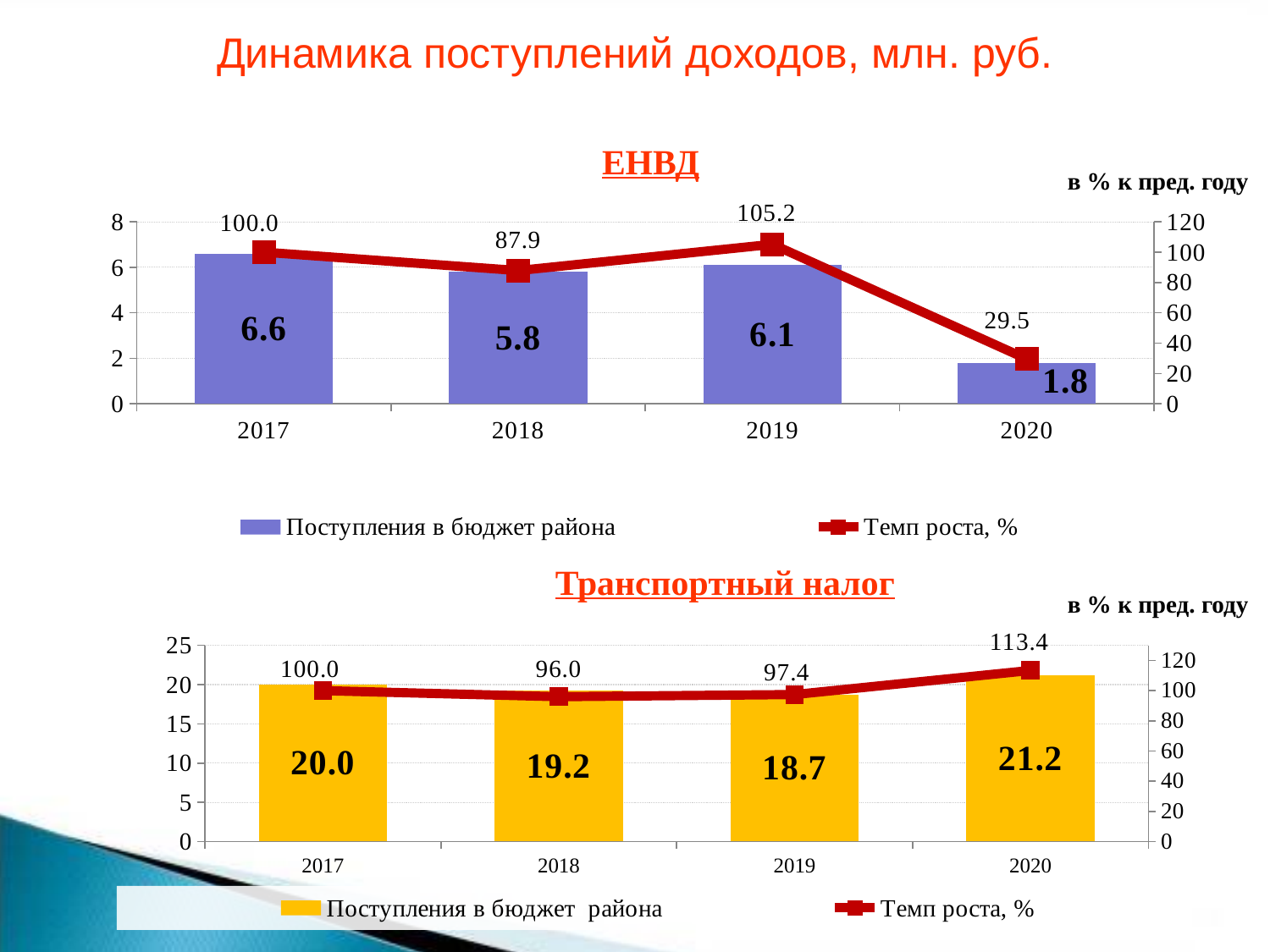
In the ЕНВД chart, what is the Темп роста, % value for 2020? 29.5 In the ЕНВД chart, what is the difference between Поступления в бюджет района in 2017 and 2018? 0.8 In the ЕНВД chart, what is the value of Поступления в бюджет района for 2019? 6.1 In the Транспортный налог chart, what is the Темп роста, % value for 2019? 97.4 In the ЕНВД chart, which year has the lowest Поступления в бюджет района? 2020 In the Транспортный налог chart, which year has the highest Поступления в бюджет района? 2020 What is the title of the top chart on the slide? ЕНВД In the Транспортный налог chart, what is the difference between Поступления в бюджет района in 2020 and 2019? 2.5 How many series does the legend of the Транспортный налог chart list? 2 In the Транспортный налог chart, what is the value of Поступления в бюджет района for 2018? 19.2 In the ЕНВД chart, how many years are shown on the x axis? 4 In the Транспортный налог chart, is Поступления в бюджет района larger in 2017 or in 2019? 2017